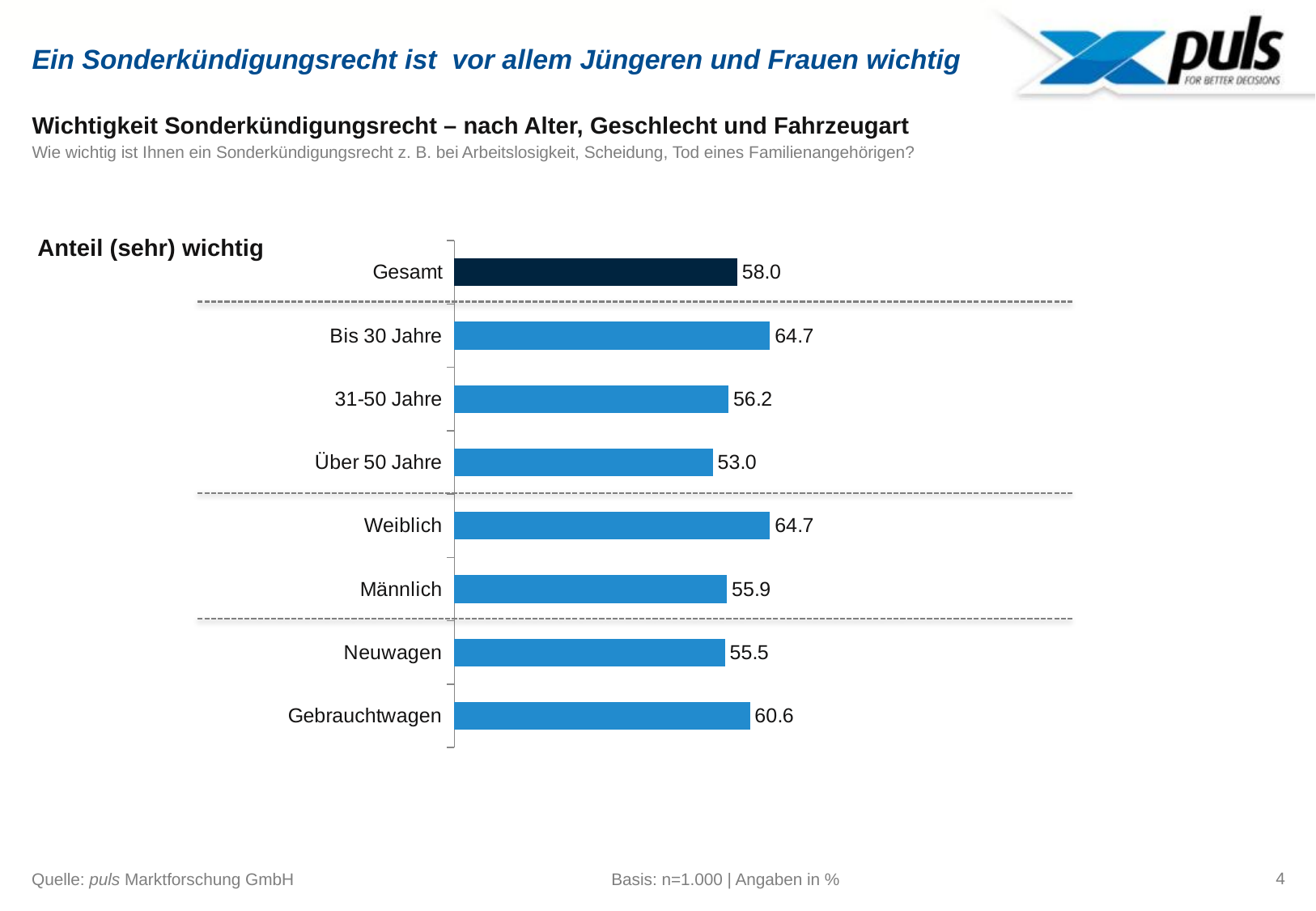
Which is larger, the value for Neuwagen or the value for Gebrauchtwagen? Gebrauchtwagen How many categories are shown in the chart? 8 What is the difference between the values for Weiblich and Männlich? 8.8 Which category has the lowest value? Über 50 Jahre What is the value for Gebrauchtwagen? 60.6 What is the difference between the values for Gebrauchtwagen and Neuwagen? 5.1 What is the value for Gesamt? 58.0 What is the value for Bis 30 Jahre? 64.7 What kind of chart is shown on the slide? Bar chart Which is larger, the value for Bis 30 Jahre or the value for 31-50 Jahre? Bis 30 Jahre What is the value for Über 50 Jahre? 53.0 Which category's bar is shown in a darker colour than the others? Gesamt